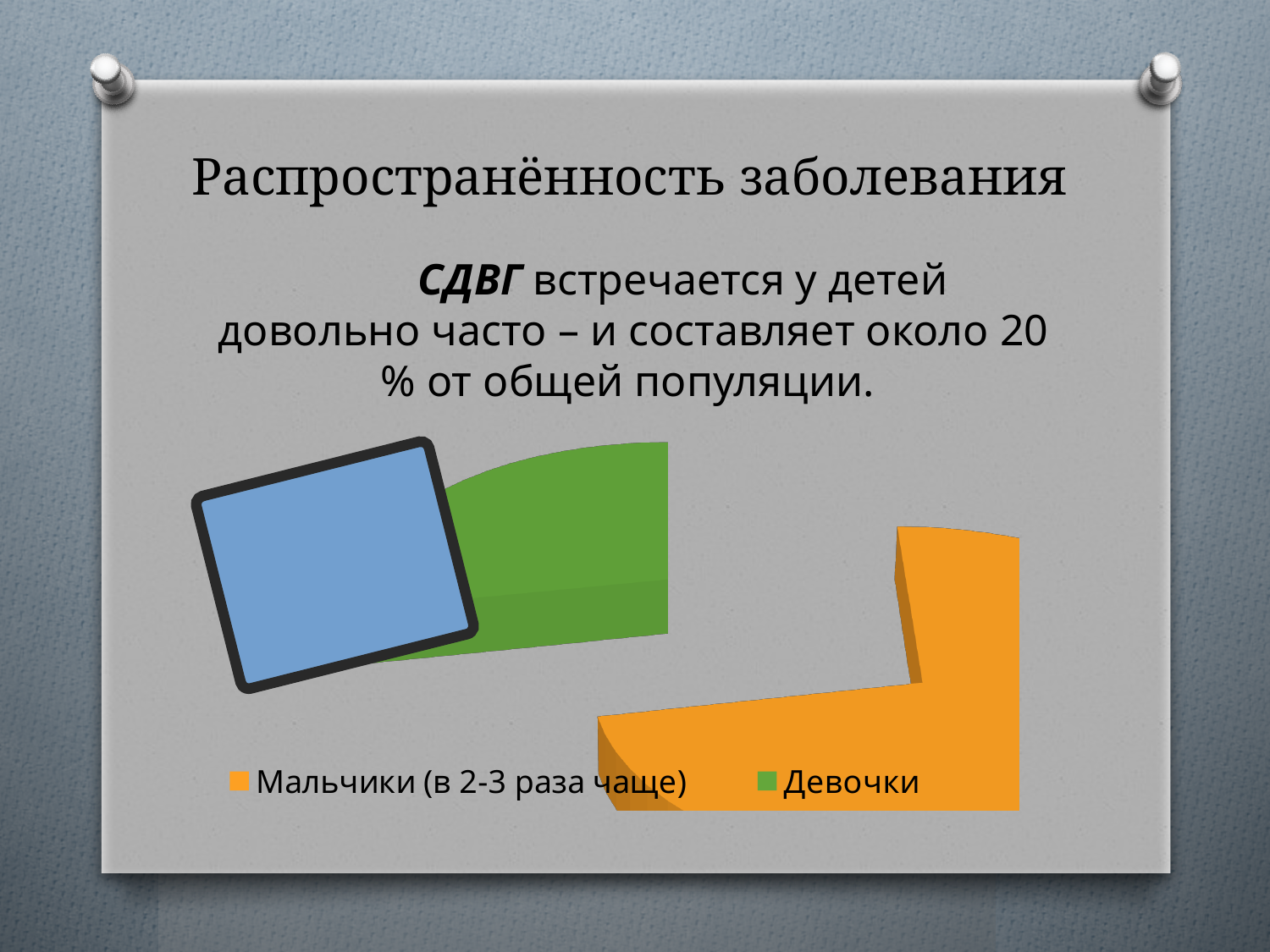
Which slice is larger in the pie chart, Мальчики (в 2-3 раза чаще) or Девочки? Мальчики (в 2-3 раза чаще) How many categories does the pie chart's legend list? 2 What kind of chart is shown on the slide? pie chart Which category has the smallest slice in the pie chart? Девочки Which category has the largest slice in the pie chart? Мальчики (в 2-3 раза чаще) What colour is the slice for Мальчики (в 2-3 раза чаще) in the pie chart? orange What colour is the slice for Девочки in the pie chart? green